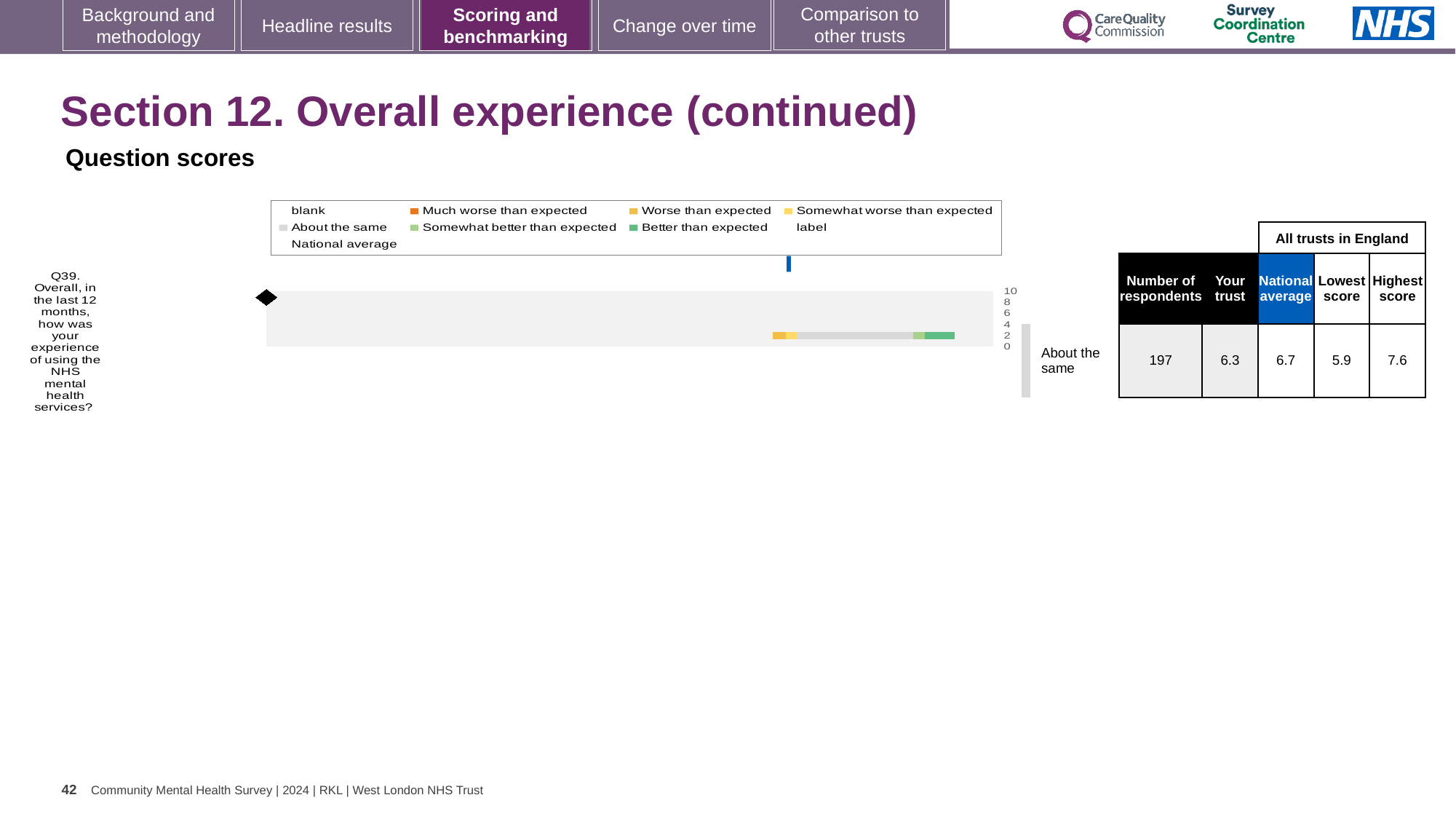
What is the difference between the national average and the 'Your trust' score for Q39? 0.4 What benchmark category label is shown to the right of the Q39 bar? About the same What kind of chart is shown on the slide for Q39? bar chart How many entries does the chart legend list? 9 What is the difference between the highest score and the lowest score for Q39? 1.7 What is the 'Your trust' score for Q39 shown in the table next to the chart? 6.3 What is the highest score among all trusts in England for Q39? 7.6 How many questions are plotted in the chart on the slide? 1 How many respondents answered Q39? 197 What is the lowest score among all trusts in England for Q39? 5.9 Which is larger for Q39: the 'Your trust' score or the national average? National average What is the national average score for Q39 shown in the table next to the chart? 6.7